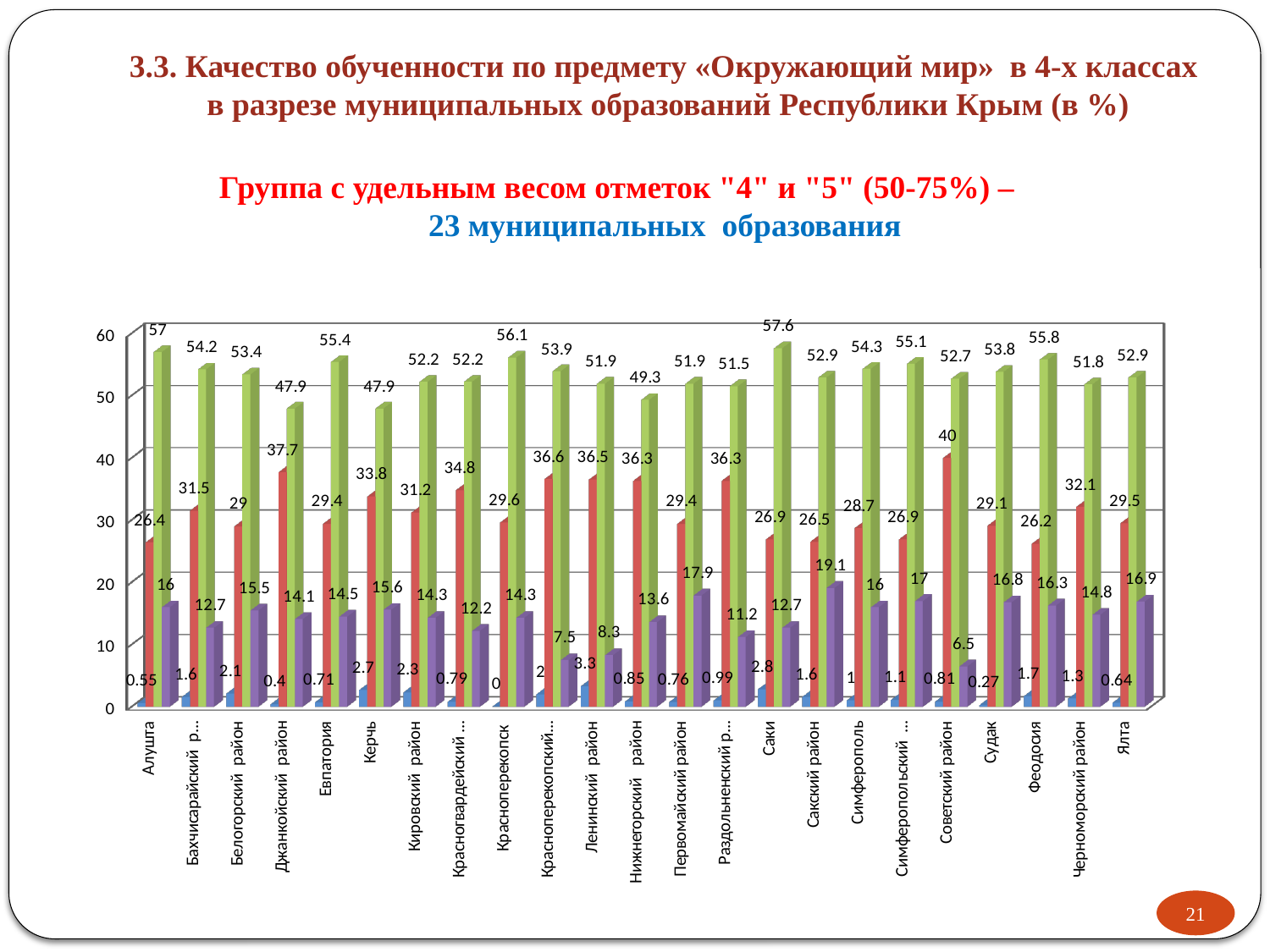
What is the value of the purple bar for Сакский район? 19.1 What is the value of the blue bar for Красноперекопск? 0 What kind of chart is shown on the slide? Bar chart What is the difference between the green bar and the red bar for Алушта? 30.6 Which municipality has the lowest purple bar? Советский район What is the value of the red bar for Советский район? 40 Which municipality has the highest blue bar? Ленинский район Which municipality has the highest red bar? Советский район How many municipalities are shown on the x axis of the chart? 23 Which is larger: the purple bar for Первомайский район or the purple bar for Ялта? Первомайский район What is the value of the green bar for Саки? 57.6 Which municipality has the highest green bar? Саки